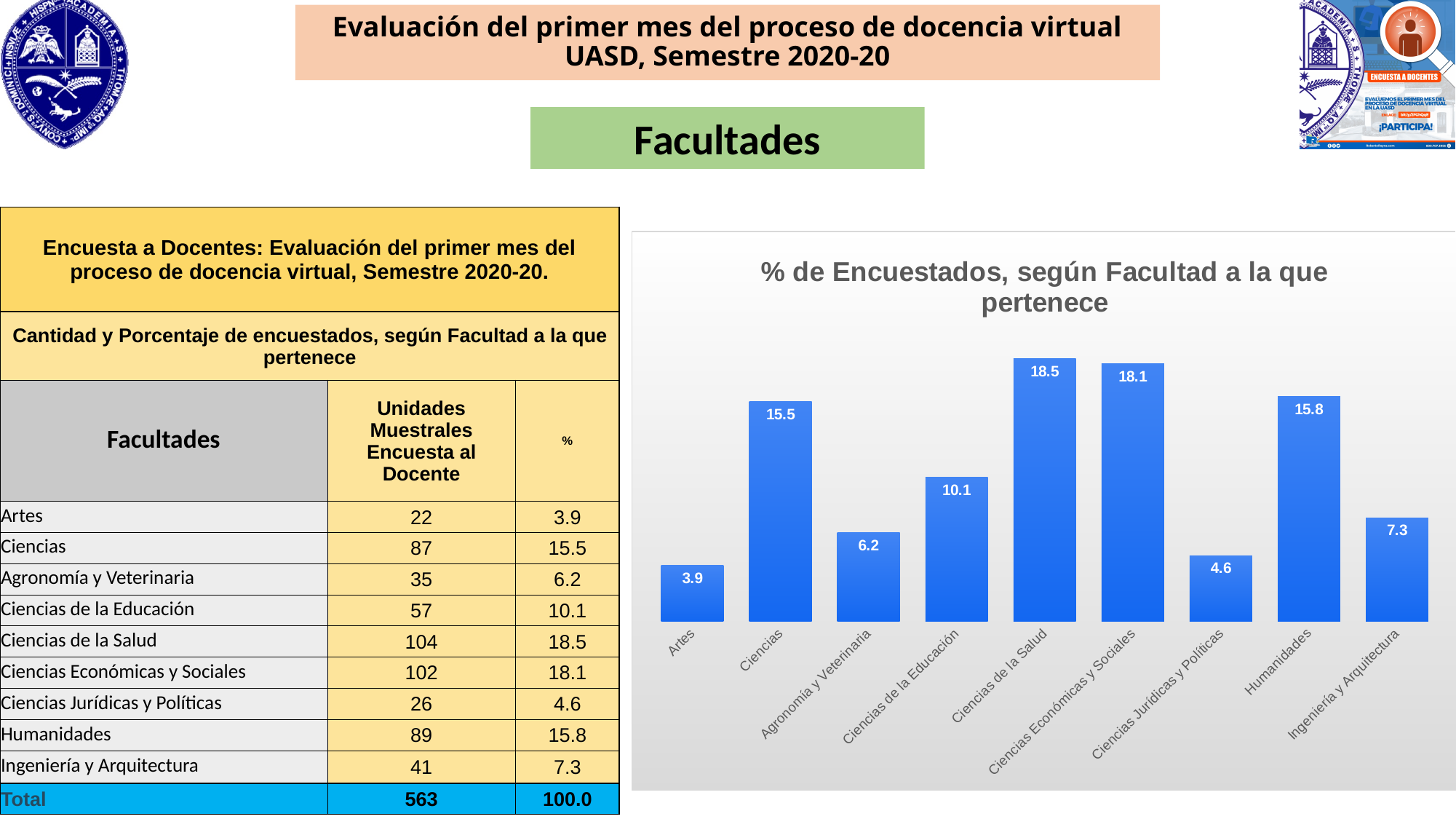
What kind of chart is shown on the slide? Bar chart What is the value for Artes in the chart? 3.9 Which faculty has the lowest value in the chart? Artes What is the value for Humanidades in the chart? 15.8 What is the title of the chart? % de Encuestados, según Facultad a la que pertenece Which faculty has the highest value in the chart? Ciencias de la Salud Which is larger, the value for Ingeniería y Arquitectura or the value for Ciencias Jurídicas y Políticas? Ingeniería y Arquitectura How many faculties are shown in the chart? 9 What is the difference between the values for Ciencias de la Salud and Ciencias Económicas y Sociales? 0.4 What is the value for Ciencias de la Salud in the chart? 18.5 What is the difference between the values for Ciencias and Agronomía y Veterinaria? 9.3 Which is larger, the value for Humanidades or the value for Ciencias? Humanidades